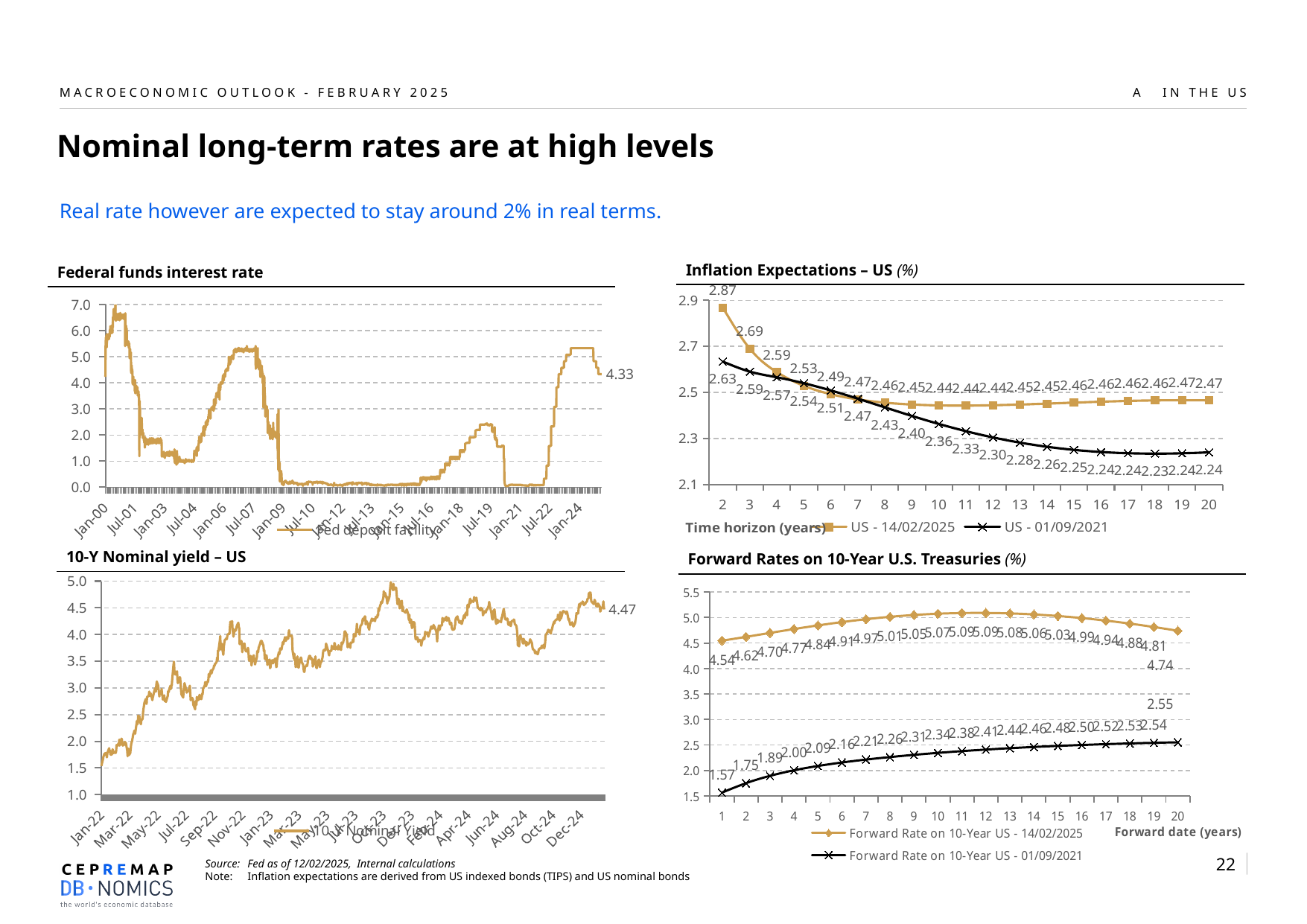
On the Forward Rates on 10-Year U.S. Treasuries chart, does the Forward Rate on 10-Year US - 01/09/2021 series rise or fall as the forward date increases? rise On the Forward Rates on 10-Year U.S. Treasuries chart, what is the value for Forward Rate on 10-Year US - 01/09/2021 at a forward date of 20 years? 2.55 On the Federal funds interest rate chart, what is the value printed at the end of the series? 4.33 On the Inflation Expectations – US chart, which time horizon has the highest value for the US - 14/02/2025 series? 2 How many series does the legend of the Forward Rates on 10-Year U.S. Treasuries chart list? 2 On the Inflation Expectations – US chart, what is the value for US - 14/02/2025 at a time horizon of 2 years? 2.87 What kind of chart is the 10-Y Nominal yield – US chart? line chart On the Forward Rates on 10-Year U.S. Treasuries chart, which forward date has the lowest value for the Forward Rate on 10-Year US - 01/09/2021 series? 1 On the Inflation Expectations – US chart, what is the value for US - 01/09/2021 at a time horizon of 20 years? 2.24 On the Forward Rates on 10-Year U.S. Treasuries chart, what is the value for Forward Rate on 10-Year US - 14/02/2025 at a forward date of 1 year? 4.54 On the Inflation Expectations – US chart, what is the difference between the US - 14/02/2025 and US - 01/09/2021 values at a time horizon of 2 years? 0.24 On the 10-Y Nominal yield – US chart, what is the value printed at the end of the series? 4.47